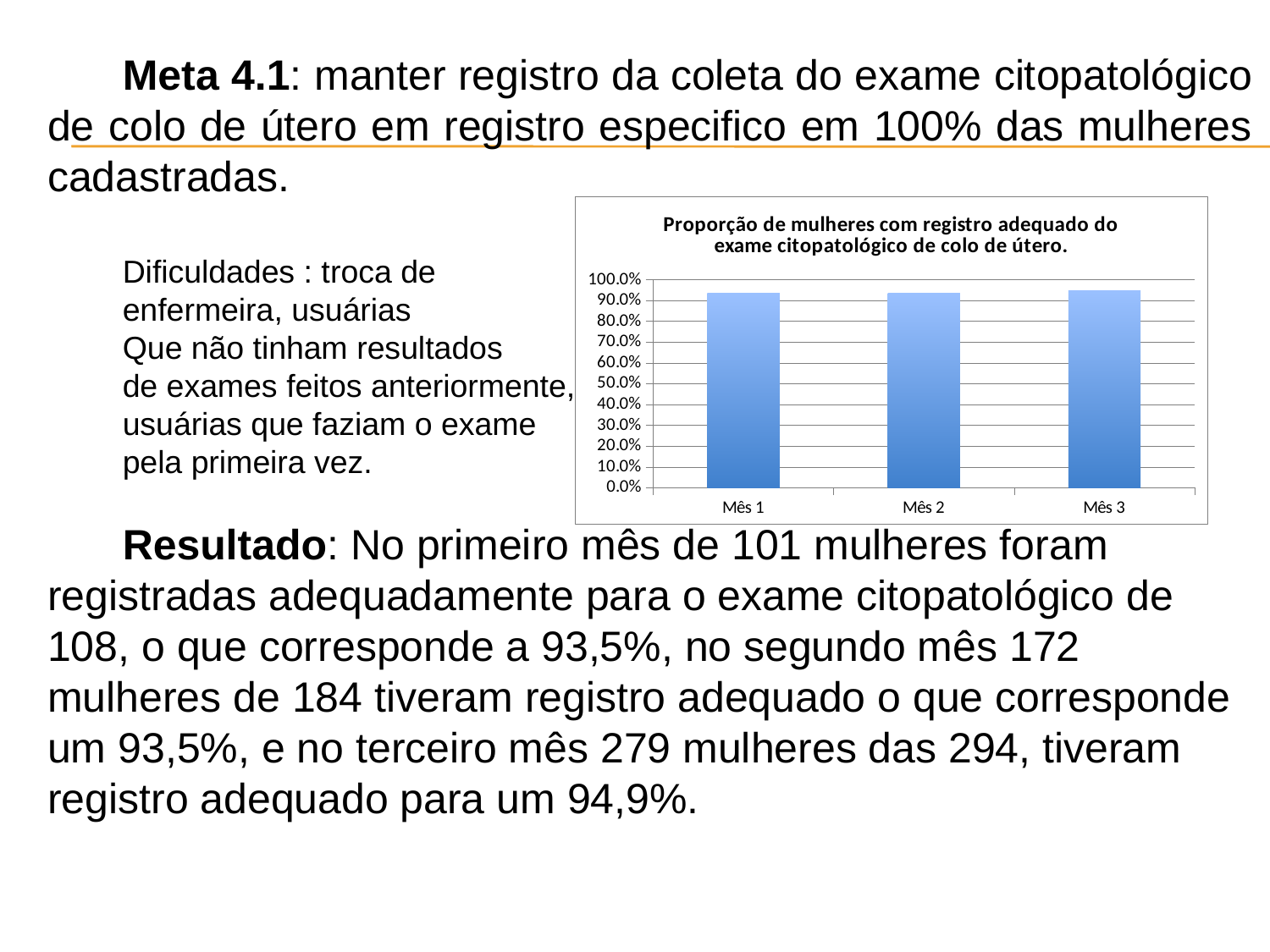
Is the value for Mês 1 greater or less than 90.0%? greater How many categories (months) are shown on the x axis of the chart? 3 Is the value for Mês 3 greater or less than 100.0%? less Is the value for Mês 3 greater or less than 90.0%? greater What kind of chart is shown on the slide? bar chart What is the title of the chart? Proporção de mulheres com registro adequado do exame citopatológico de colo de útero. What is the label of the first category on the x axis of the chart? Mês 1